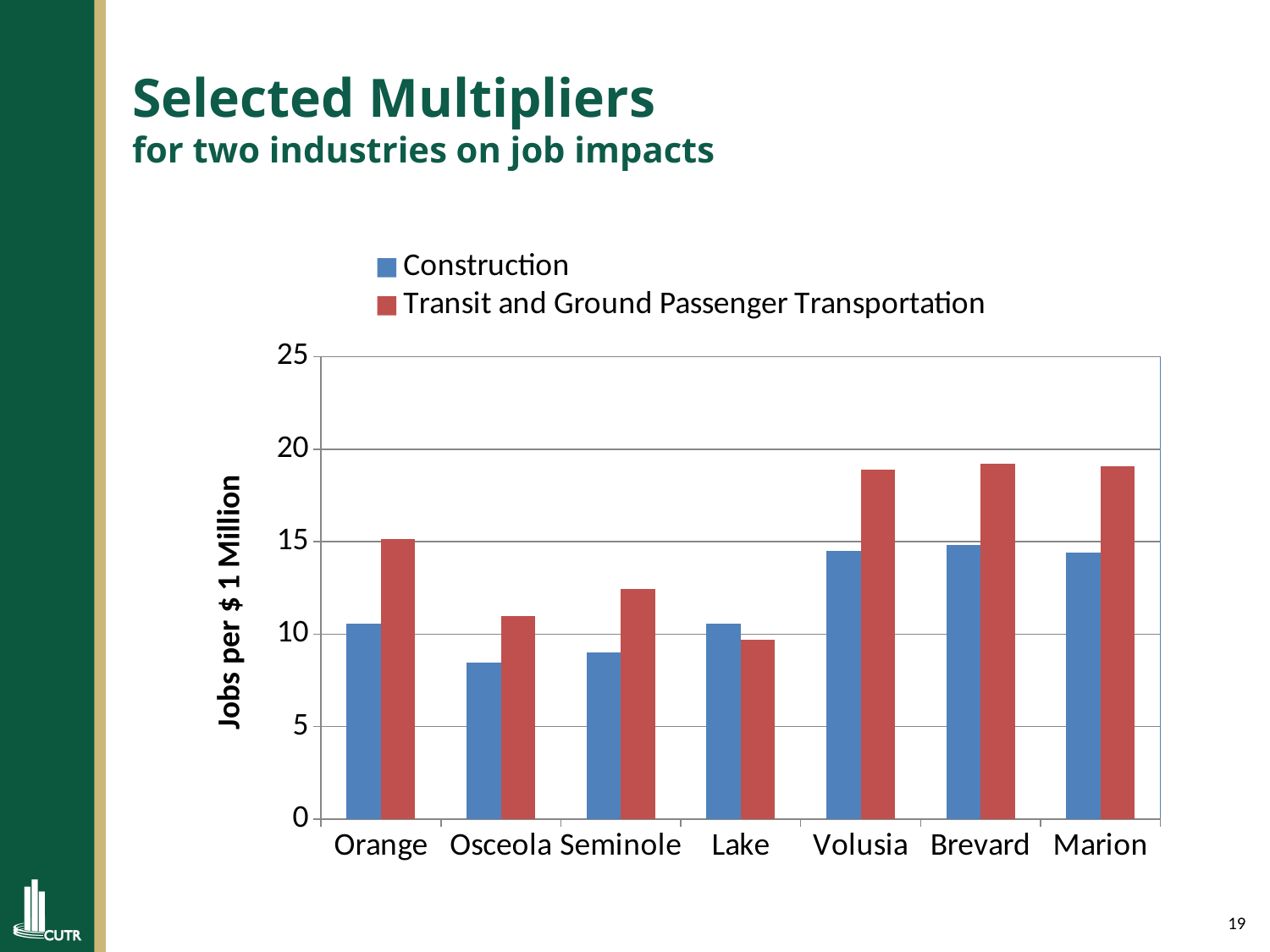
Which county has the lowest Transit and Ground Passenger Transportation value? Lake Is the Transit and Ground Passenger Transportation value for Volusia greater or less than 15? greater For Orange, which series has the larger value, Construction or Transit and Ground Passenger Transportation? Transit and Ground Passenger Transportation Is the Construction value for Osceola greater or less than 10? less How many series does the legend list? 2 Is the Transit and Ground Passenger Transportation value for Seminole greater or less than 10? greater Which county has the lowest Construction value? Osceola What kind of chart is shown on the slide? bar chart How many counties are shown on the x axis? 7 What is the label on the vertical axis of the chart? Jobs per $ 1 Million For Lake, which series has the larger value, Construction or Transit and Ground Passenger Transportation? Construction